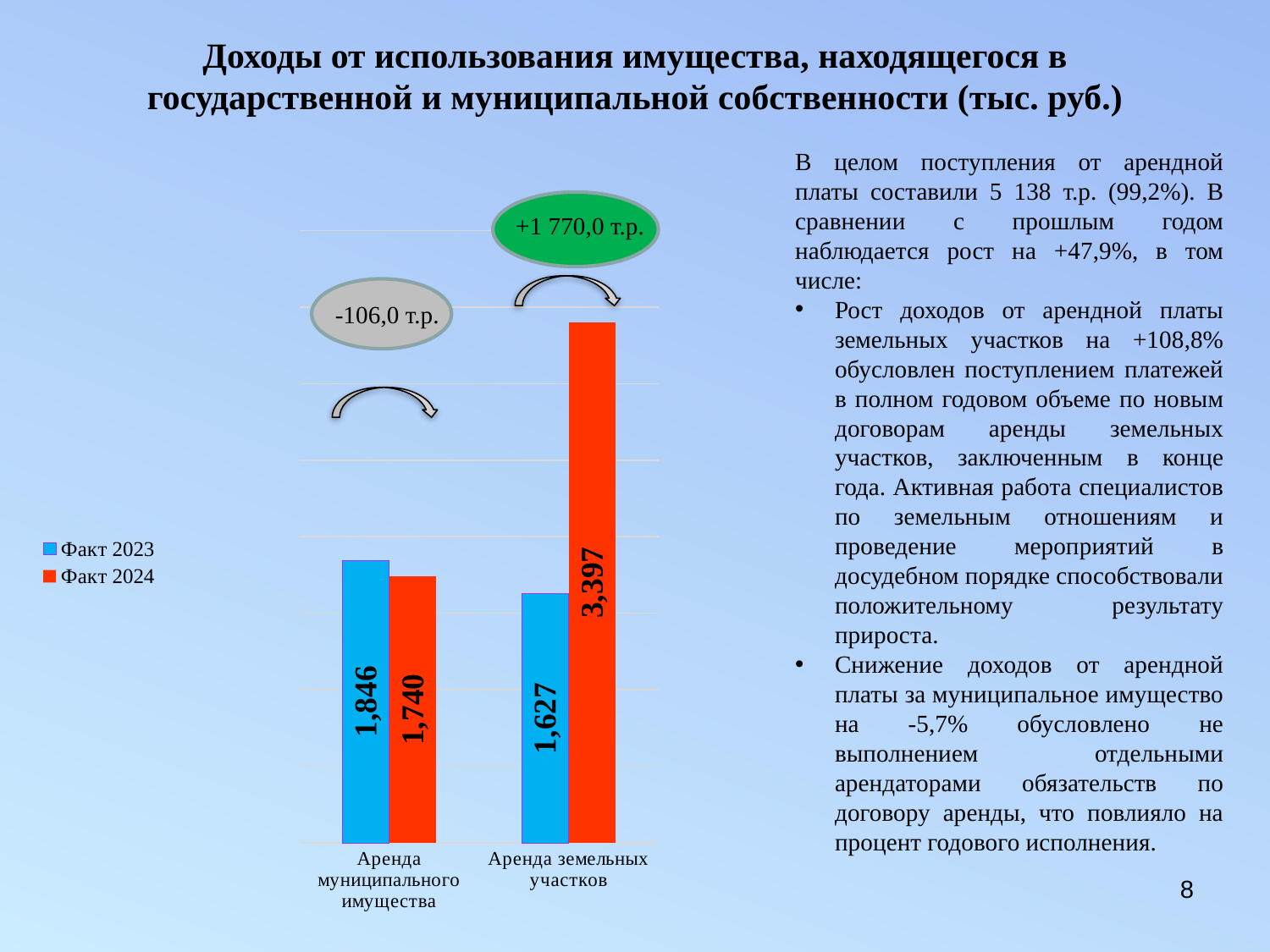
How many series does the chart legend list? 2 What is the Факт 2024 value for Аренда земельных участков? 3,397 What is the Факт 2023 value for Аренда земельных участков? 1,627 Which bar in the chart has the lowest value? Факт 2023, Аренда земельных участков What is the difference between the Факт 2023 and Факт 2024 values for Аренда муниципального имущества? 106 What is the difference between the Факт 2024 and Факт 2023 values for Аренда земельных участков? 1,770 Which bar in the chart has the highest value? Факт 2024, Аренда земельных участков What type of chart is shown on the slide? Bar chart For Аренда муниципального имущества, which is larger: Факт 2023 or Факт 2024? Факт 2023 How many categories are shown on the x axis of the chart? 2 What is the Факт 2024 value for Аренда муниципального имущества? 1,740 What is the Факт 2023 value for Аренда муниципального имущества? 1,846